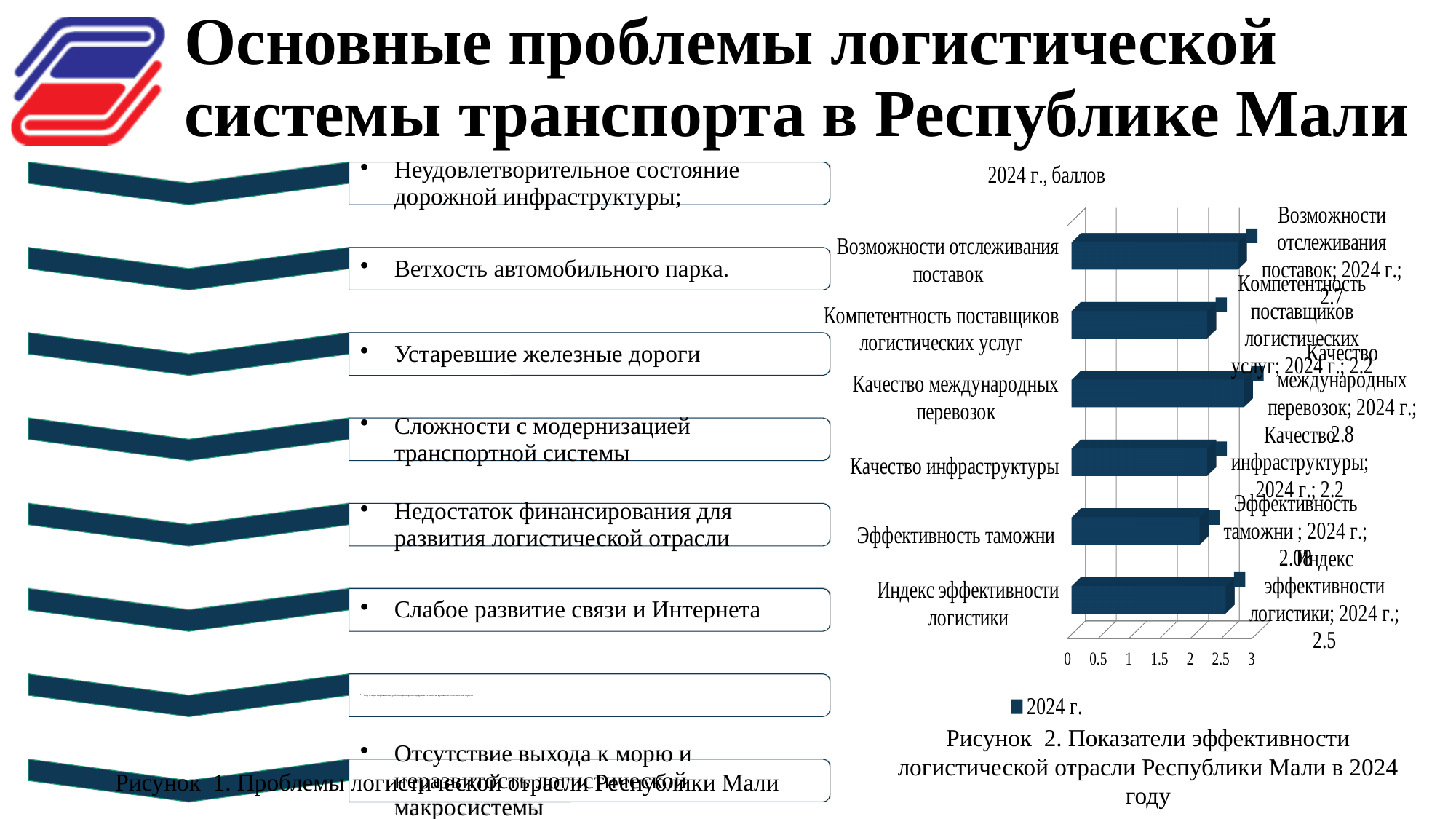
What is the value for Качество международных перевозок in the chart? 2.8 What is the value for Качество инфраструктуры in the chart? 2.2 How many categories are shown in the chart? 6 Which category has the highest value in the chart? Качество международных перевозок What type of chart is shown on the right side of the slide? bar chart What is the value for Индекс эффективности логистики in the chart? 2.5 How many series does the chart legend list? 1 Is the value for Эффективность таможни greater or less than 2.5? less What is the difference between the values for Качество международных перевозок and Качество инфраструктуры? 0.6 Which is larger: the value for Возможности отслеживания поставок or the value for Индекс эффективности логистики? Возможности отслеживания поставок What is the value for Компетентность поставщиков логистических услуг in the chart? 2.2 What is the value for Возможности отслеживания поставок in the chart? 2.7